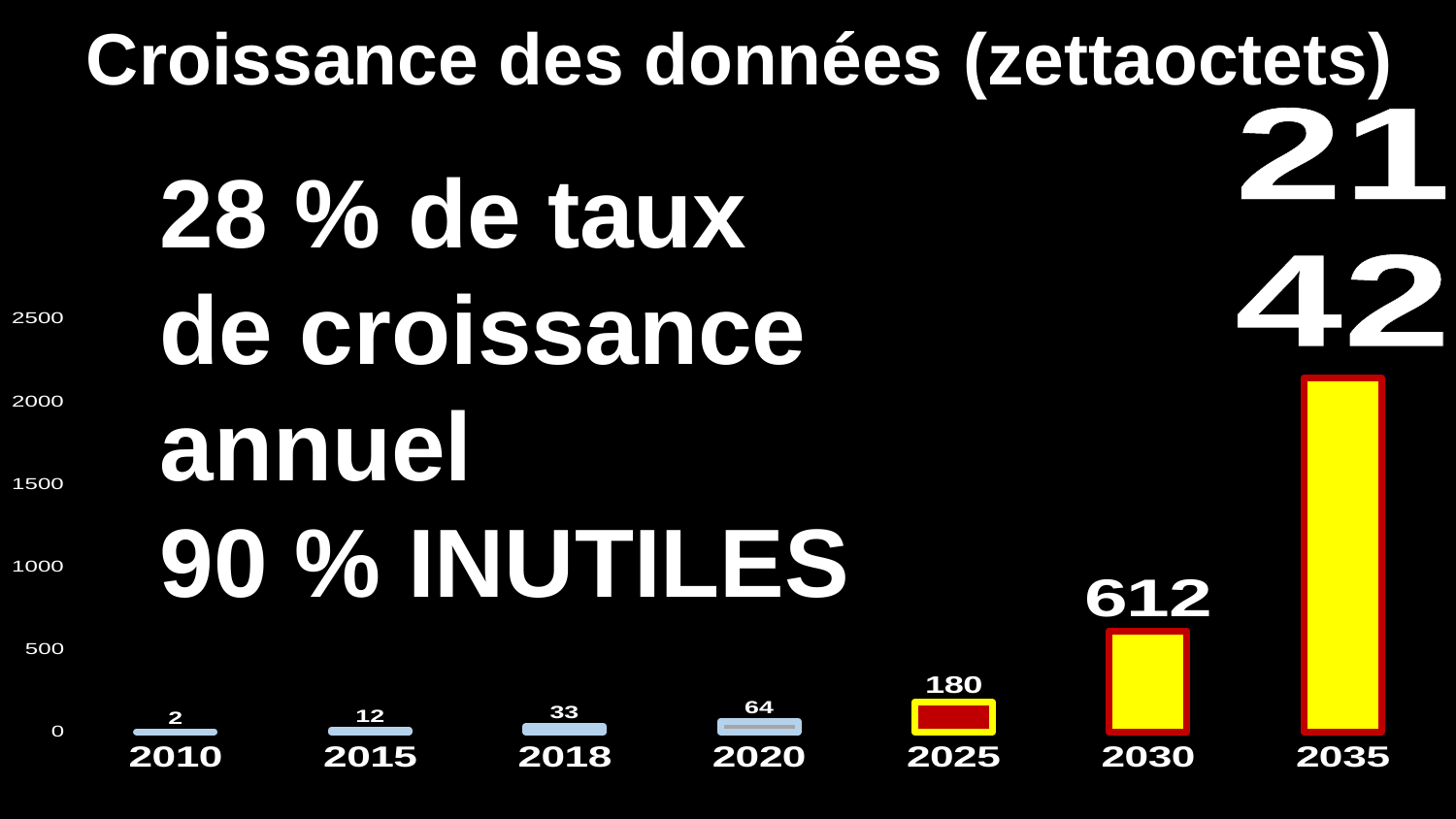
How many years are shown on the x axis? 7 What kind of chart is this? bar chart Which is larger, the value for 2018 or the value for 2020? 2020 What is the value for 2025? 180 Which year has the highest value? 2035 What is the difference between the values for 2030 and 2025? 432 What is the value for 2010? 2 What is the value for 2030? 612 What is the value for 2020? 64 Which year has the lowest value? 2010 What is the title of the chart? Croissance des données (zettaoctets) Is the value for 2035 greater or less than 2000? greater